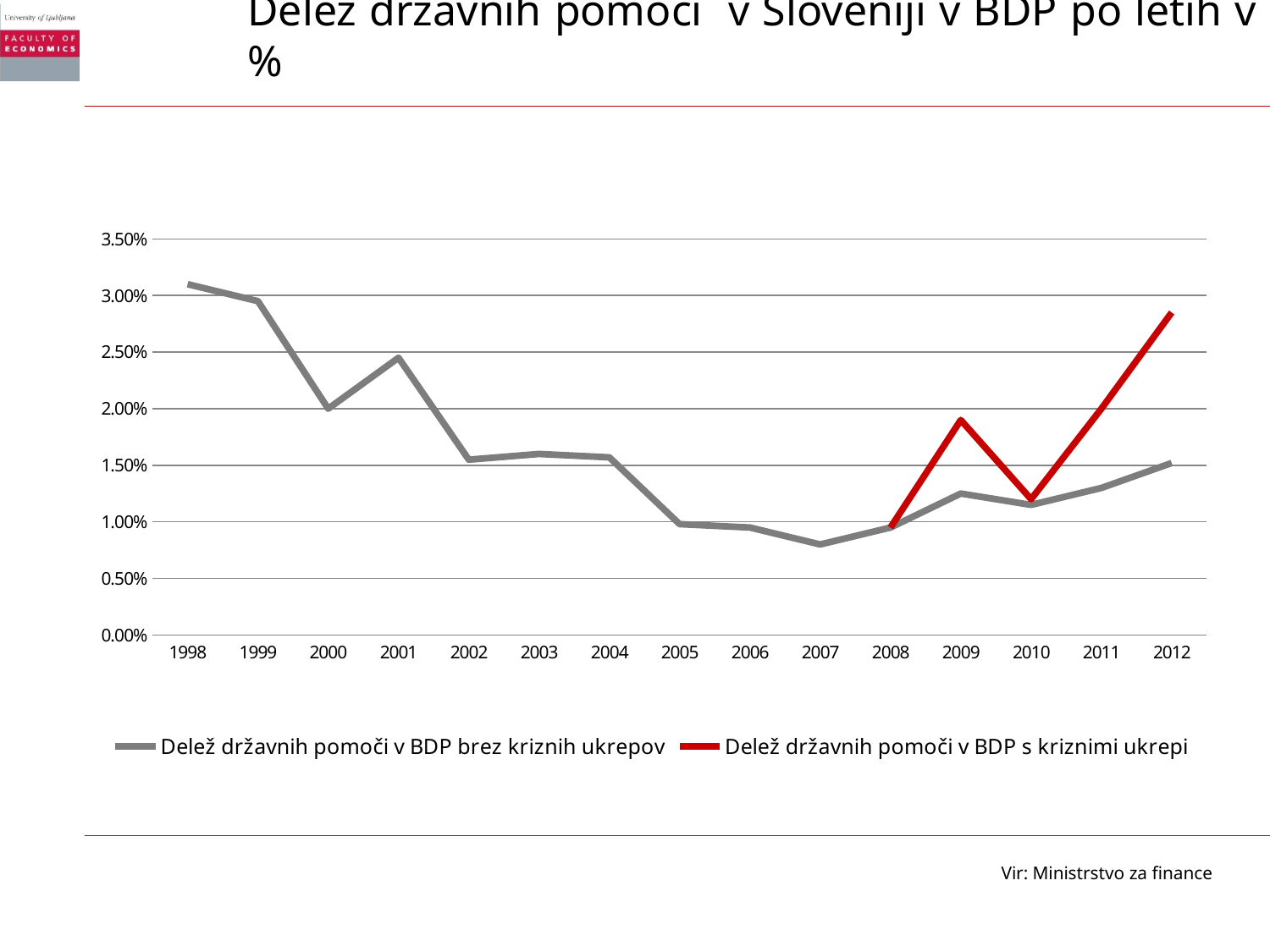
Does the series 'Delež državnih pomoči v BDP brez kriznih ukrepov' generally rise or fall from 1998 to 2007? fall In which year is the series 'Delež državnih pomoči v BDP brez kriznih ukrepov' at its lowest? 2007 How many series does the legend list? 2 Is the value for 2012 in the series 'Delež državnih pomoči v BDP s kriznimi ukrepi' greater or less than 2.50%? greater In 2012, which series has the larger value: 'brez kriznih ukrepov' or 's kriznimi ukrepi'? Delež državnih pomoči v BDP s kriznimi ukrepi In which year is the series 'Delež državnih pomoči v BDP brez kriznih ukrepov' at its highest? 1998 In which year does the series 'Delež državnih pomoči v BDP s kriznimi ukrepi' reach its highest value? 2012 How many years are shown on the x axis? 15 Is the value for 1999 in the series 'Delež državnih pomoči v BDP brez kriznih ukrepov' greater or less than 2.50%? greater Is the value for 2007 in the series 'Delež državnih pomoči v BDP brez kriznih ukrepov' greater or less than 1.00%? less Which colour is used for the series 'Delež državnih pomoči v BDP s kriznimi ukrepi'? red What kind of chart is shown on the slide? line chart